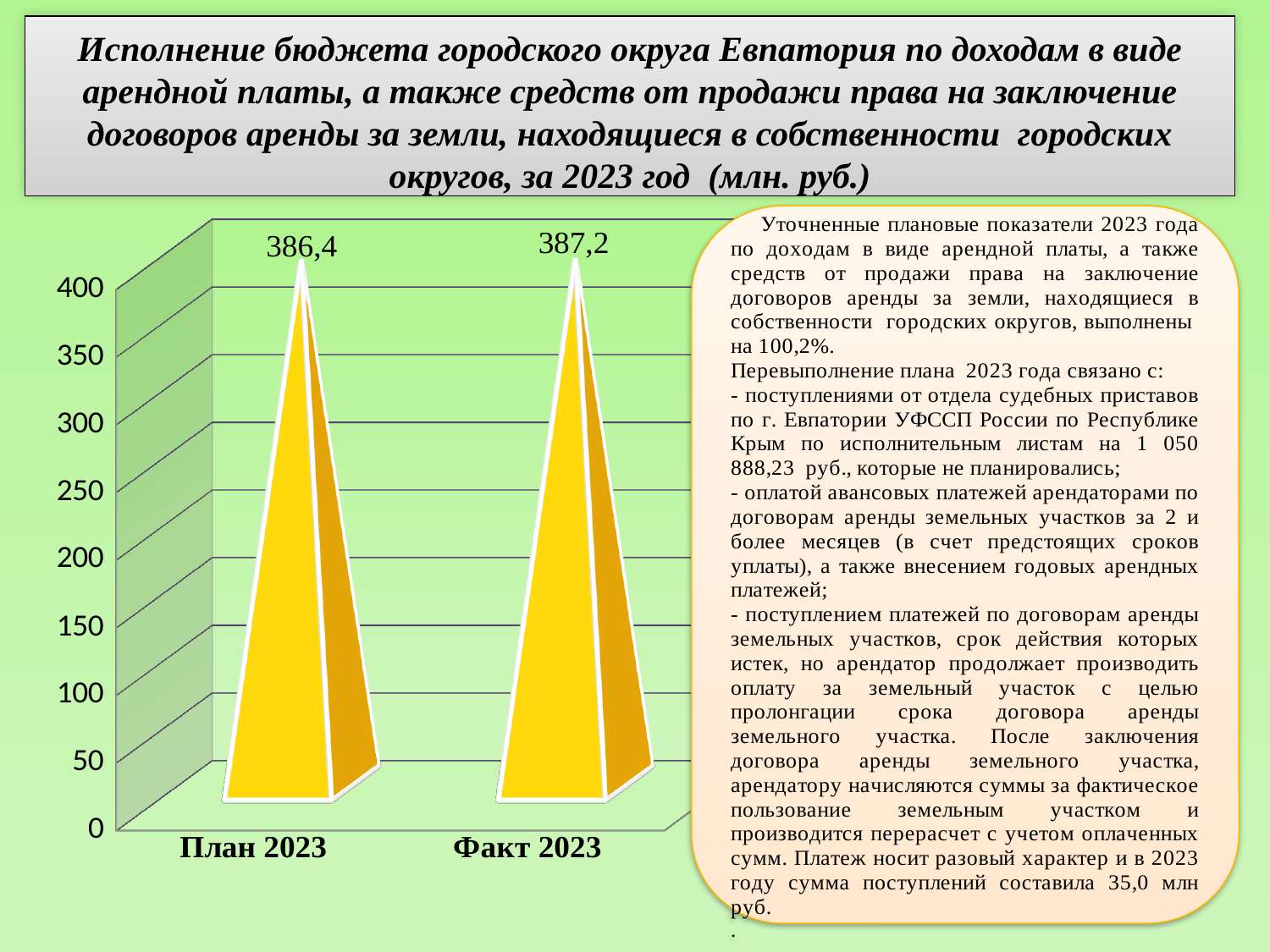
What is the value for План 2023? 386,4 What is the value for Факт 2023? 387,2 How many categories are shown on the chart? 2 Which category has the lowest value? План 2023 Is the value for Факт 2023 greater or less than 400? less What kind of chart is shown on the slide? bar chart What is the difference between the values for Факт 2023 and План 2023? 0,8 What is the highest tick value shown on the vertical axis? 400 Which category has the higher value, План 2023 or Факт 2023? Факт 2023 What colour are the bars on the chart? yellow Which category has the highest value? Факт 2023 Is the value for План 2023 greater or less than 350? greater